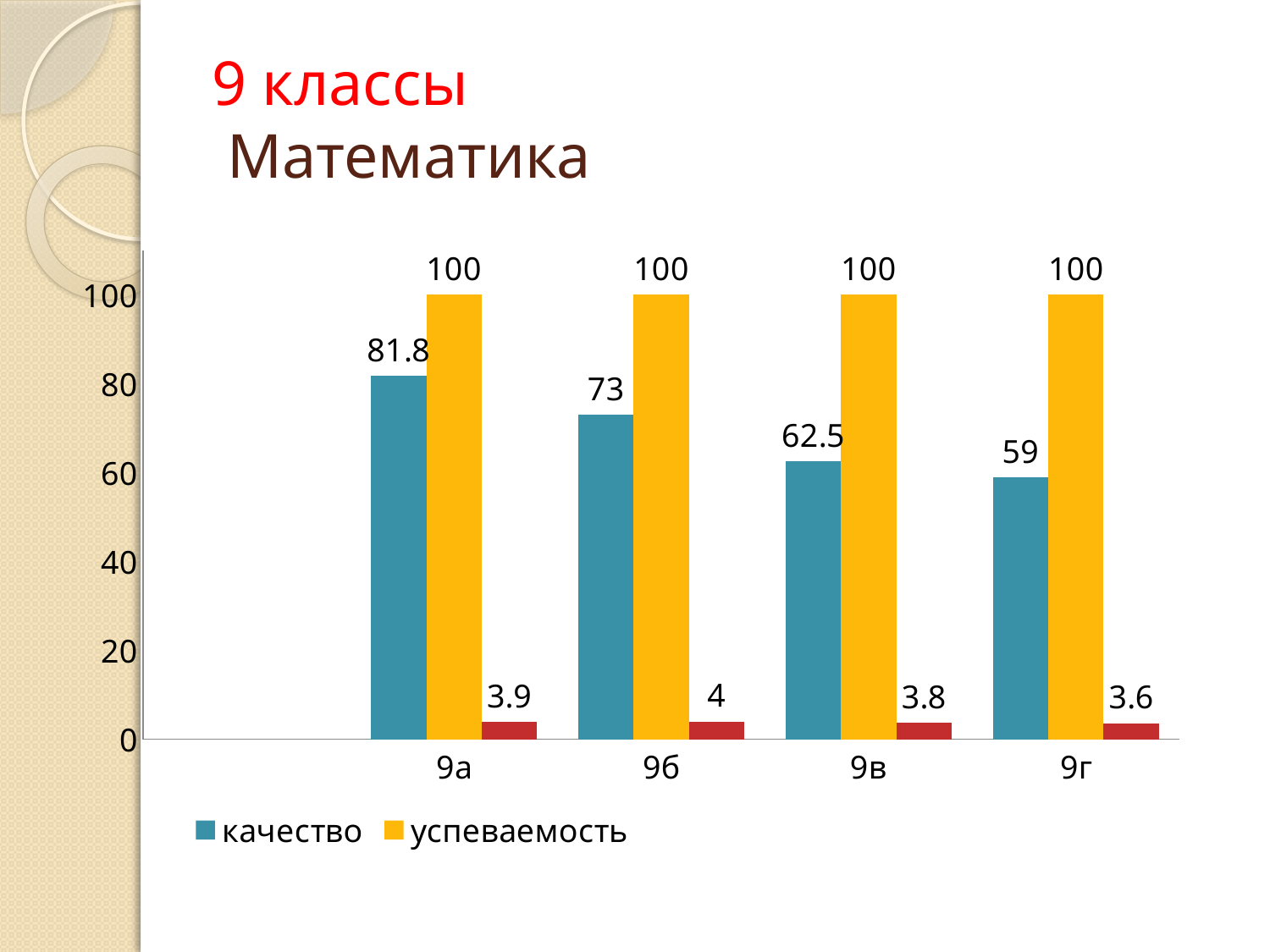
What is the успеваемость value for class 9б? 100 What is the качество value for class 9а? 81.8 Which class has the highest качество value? 9а What is the difference between the качество values for 9а and 9г? 22.8 How many classes are shown on the x axis? 4 How many series does the legend list? 2 What kind of chart is shown on the slide? bar chart Is the качество value for 9г greater or less than 60? less Do the качество values rise or fall from 9а to 9г? fall What is the качество value for class 9в? 62.5 Which is larger, the качество value for 9б or for 9в? 9б Which class has the lowest качество value? 9г